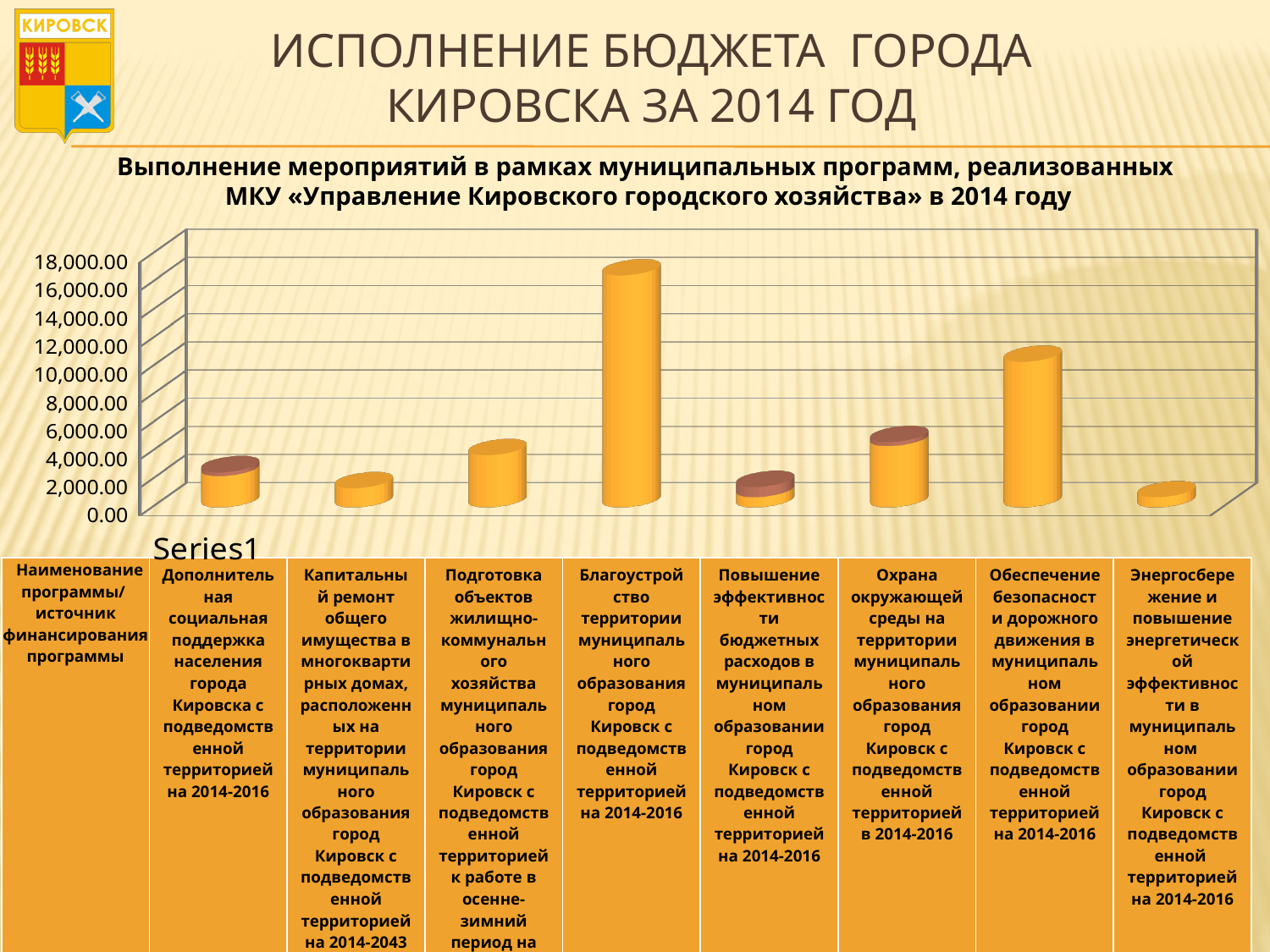
What kind of chart is shown on the slide? Bar chart Which programme has the lowest value in the chart? Энергосбережение и повышение энергетической эффективности Which is larger: the value for «Охрана окружающей среды» or the value for «Капитальный ремонт общего имущества в многоквартирных домах»? Охрана окружающей среды How many categories (programmes) are plotted in the chart? 8 What is the name of the data series shown under the chart? Series1 Is the value for «Энергосбережение и повышение энергетической эффективности» greater or less than 2,000.00? less Which programme has the highest value in the chart? Благоустройство территории муниципального образования город Кировск Which is larger: the value for «Благоустройство территории» or the value for «Обеспечение безопасности дорожного движения»? Благоустройство территории Is the value for «Благоустройство территории» greater or less than 14,000.00? greater What is the highest value shown on the vertical axis of the chart? 18,000.00 Is the value for «Обеспечение безопасности дорожного движения» greater or less than 8,000.00? greater